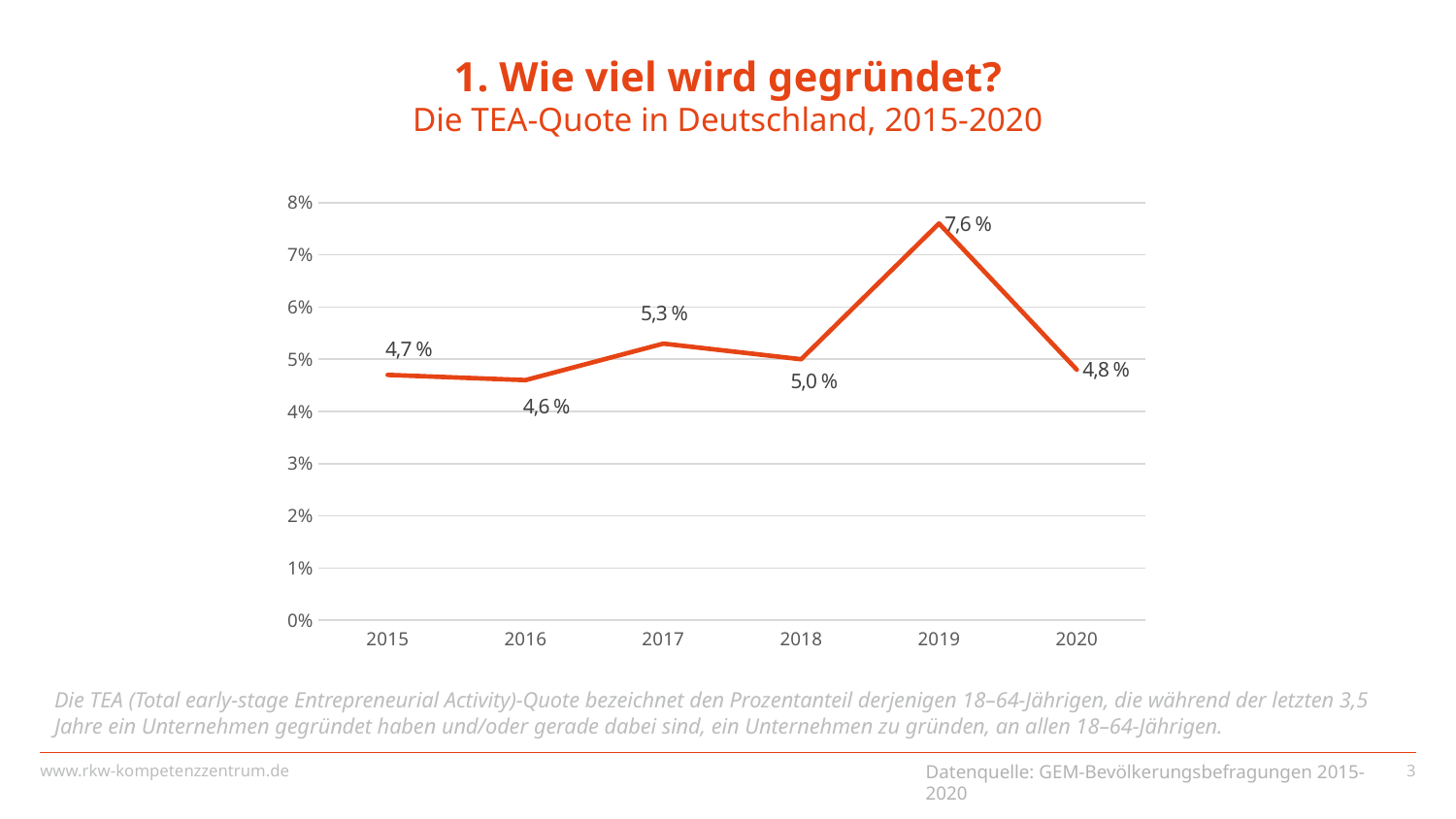
What is the subtitle of the chart on the slide? Die TEA-Quote in Deutschland, 2015-2020 What is the TEA rate for 2019? 7,6 % What kind of chart is shown on the slide? line chart Which year has the lowest TEA rate? 2016 Which year has the highest TEA rate? 2019 What is the TEA rate for 2016? 4,6 % Does the TEA rate rise or fall from 2019 to 2020? fall What is the TEA rate for 2020? 4,8 % Is the value for 2019 greater or less than 7%? greater Which year has a higher TEA rate, 2017 or 2020? 2017 What is the difference between the TEA rate in 2019 and in 2018? 2,6 % How many years are plotted on the chart? 6